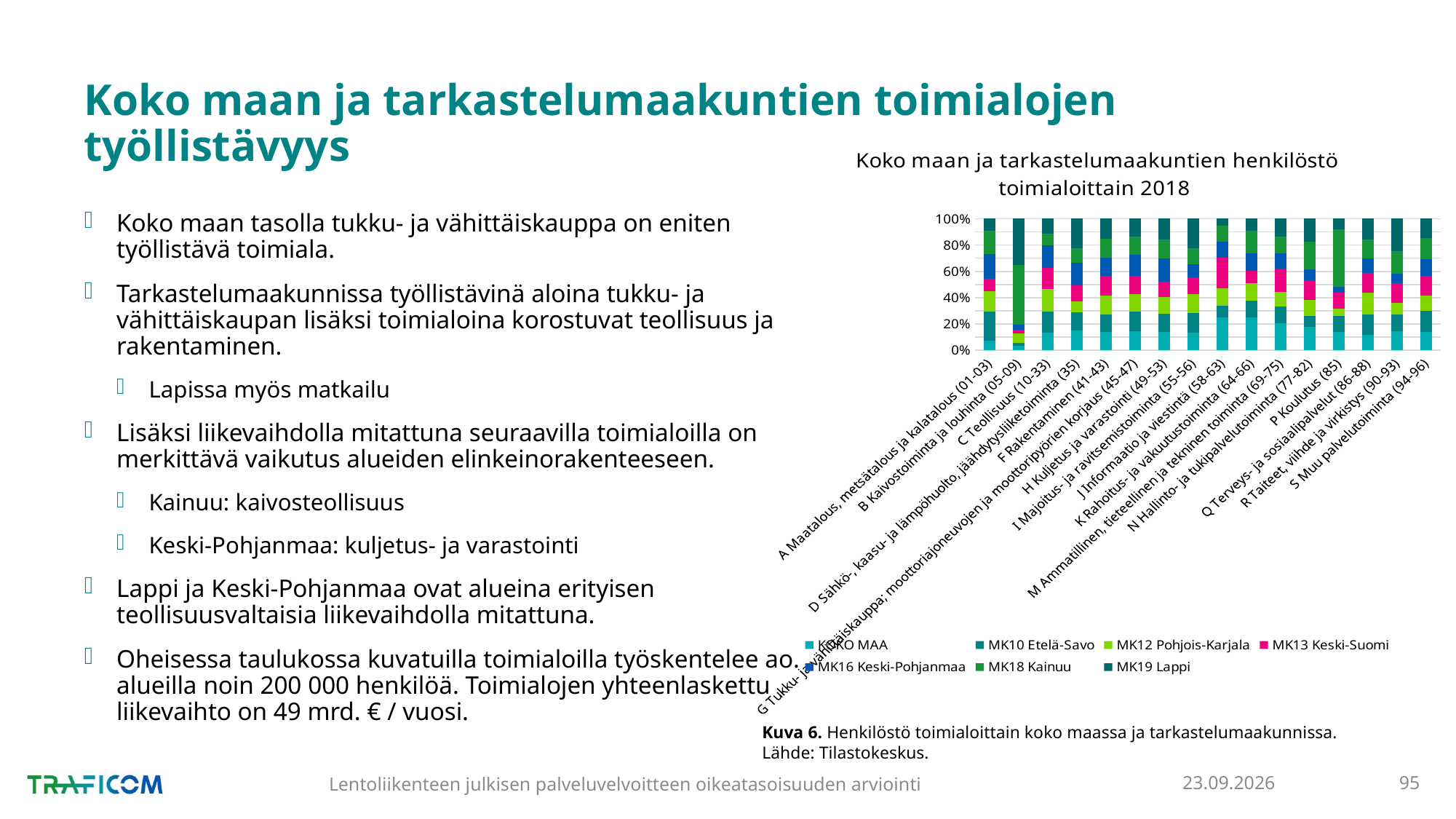
What kind of chart is shown on the slide? Stacked bar chart Which series is listed first in the chart legend? KOKO MAA What is the title of the chart? Koko maan ja tarkastelumaakuntien henkilöstö toimialoittain 2018 Is the share of KOKO MAA in the B Kaivostoiminta ja louhinta (05-09) bar greater or less than 20%? less In which category does the MK19 Lappi series take the largest share of the bar? B Kaivostoiminta ja louhinta (05-09) Is the share of MK19 Lappi in the B Kaivostoiminta ja louhinta (05-09) bar greater or less than 60%? less What is the highest value shown on the chart's y axis? 100% Which is larger in the B Kaivostoiminta ja louhinta (05-09) bar: the MK19 Lappi share or the KOKO MAA share? MK19 Lappi How many series does the chart legend list? 7 What is the total of each stacked bar in the chart? 100% How many industry categories are plotted on the x axis of the chart? 16